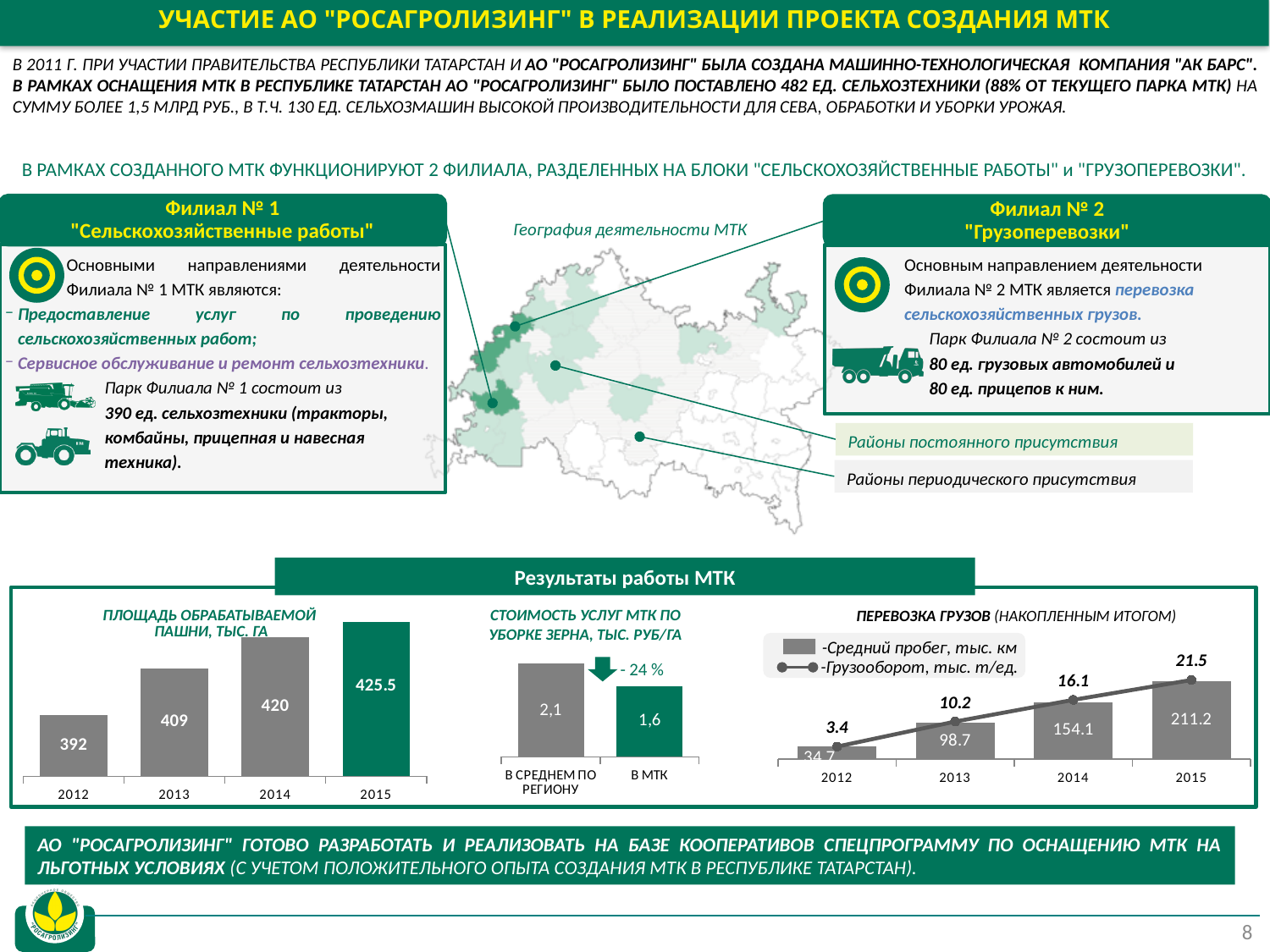
In the chart "СТОИМОСТЬ УСЛУГ МТК ПО УБОРКЕ ЗЕРНА, ТЫС. РУБ/ГА", what percentage change is shown between the two bars? - 24 % In the chart "СТОИМОСТЬ УСЛУГ МТК ПО УБОРКЕ ЗЕРНА, ТЫС. РУБ/ГА", which category has the lower value? В МТК In the chart "ПЕРЕВОЗКА ГРУЗОВ (НАКОПЛЕННЫМ ИТОГОМ)", what is the difference in "Грузооборот, тыс. т/ед." between 2013 and 2012? 6.8 In the chart "ПЛОЩАДЬ ОБРАБАТЫВАЕМОЙ ПАШНИ, ТЫС. ГА", what is the value for 2013? 409 In the chart "ПЕРЕВОЗКА ГРУЗОВ (НАКОПЛЕННЫМ ИТОГОМ)", what is the value of "Грузооборот, тыс. т/ед." for 2015? 21.5 In the chart "ПЛОЩАДЬ ОБРАБАТЫВАЕМОЙ ПАШНИ, ТЫС. ГА", do the values rise or fall from 2012 to 2015? rise In the chart "СТОИМОСТЬ УСЛУГ МТК ПО УБОРКЕ ЗЕРНА, ТЫС. РУБ/ГА", what is the value for "В МТК"? 1,6 How many series does the legend list in the chart "ПЕРЕВОЗКА ГРУЗОВ (НАКОПЛЕННЫМ ИТОГОМ)"? 2 In the chart "ПЕРЕВОЗКА ГРУЗОВ (НАКОПЛЕННЫМ ИТОГОМ)", what is the value of "Средний пробег, тыс. км" for 2014? 154.1 In the chart "ПЛОЩАДЬ ОБРАБАТЫВАЕМОЙ ПАШНИ, ТЫС. ГА", which year has the highest value? 2015 How many years are shown in the chart "ПЛОЩАДЬ ОБРАБАТЫВАЕМОЙ ПАШНИ, ТЫС. ГА"? 4 In the chart "ПЛОЩАДЬ ОБРАБАТЫВАЕМОЙ ПАШНИ, ТЫС. ГА", what is the difference between the 2015 and 2012 values? 33.5